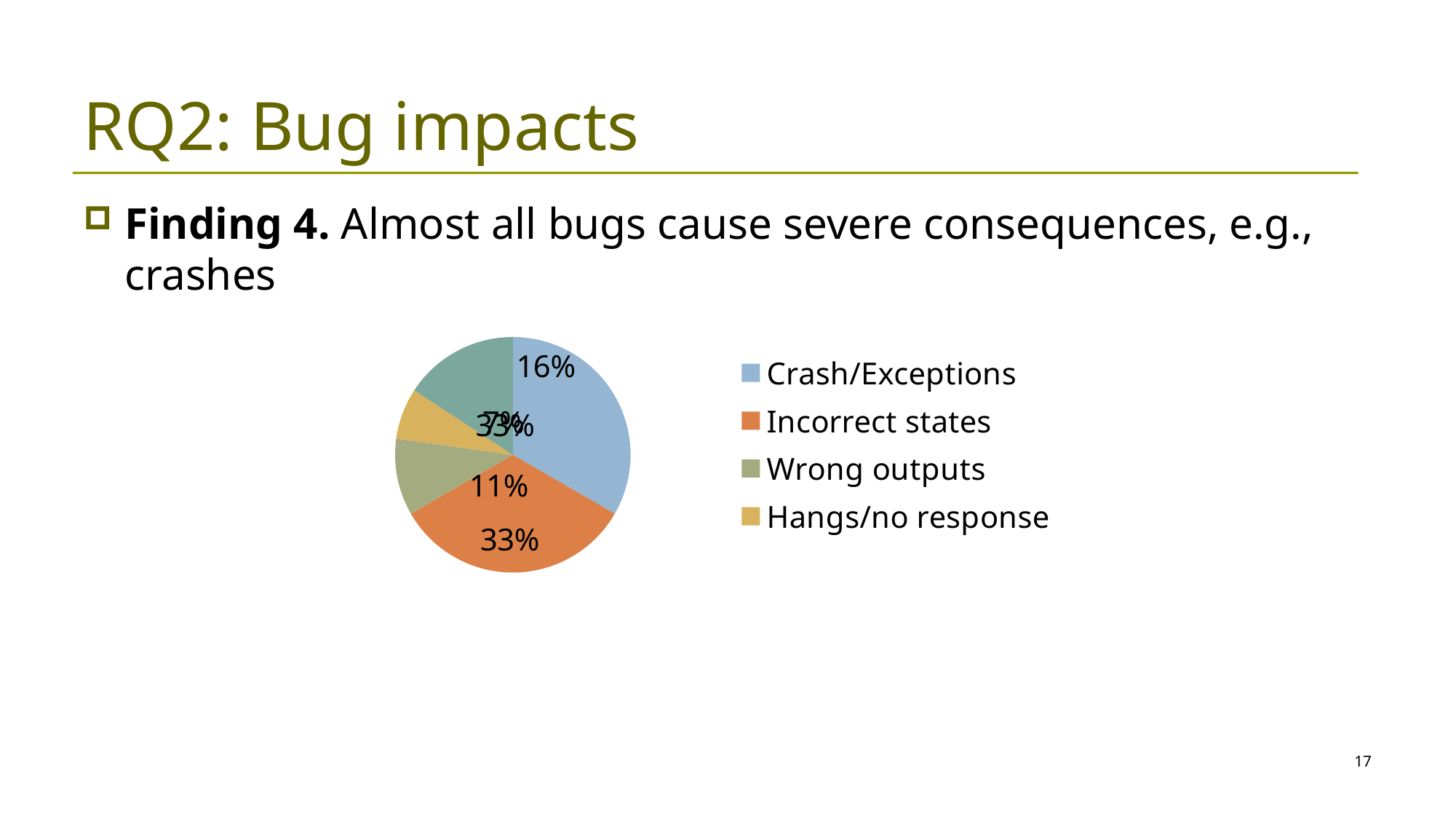
How many slices does the pie chart have? 5 Which legend entry is shown in orange? Incorrect states Which is larger, the slice for Wrong outputs or the slice for Hangs/no response? Wrong outputs Which is larger, the slice for Crash/Exceptions or the slice for Wrong outputs? Crash/Exceptions What percentage of bugs cause Incorrect states? 33% How many entries does the legend list? 4 What kind of chart is shown on the slide? Pie chart Which is larger, the slice for Incorrect states or the slice for Wrong outputs? Incorrect states What is the first entry listed in the legend? Crash/Exceptions Which legend category has the smallest slice of the pie? Hangs/no response What percentage of bugs cause Wrong outputs? 11% By how many percentage points does the Incorrect states share exceed the Wrong outputs share? 22